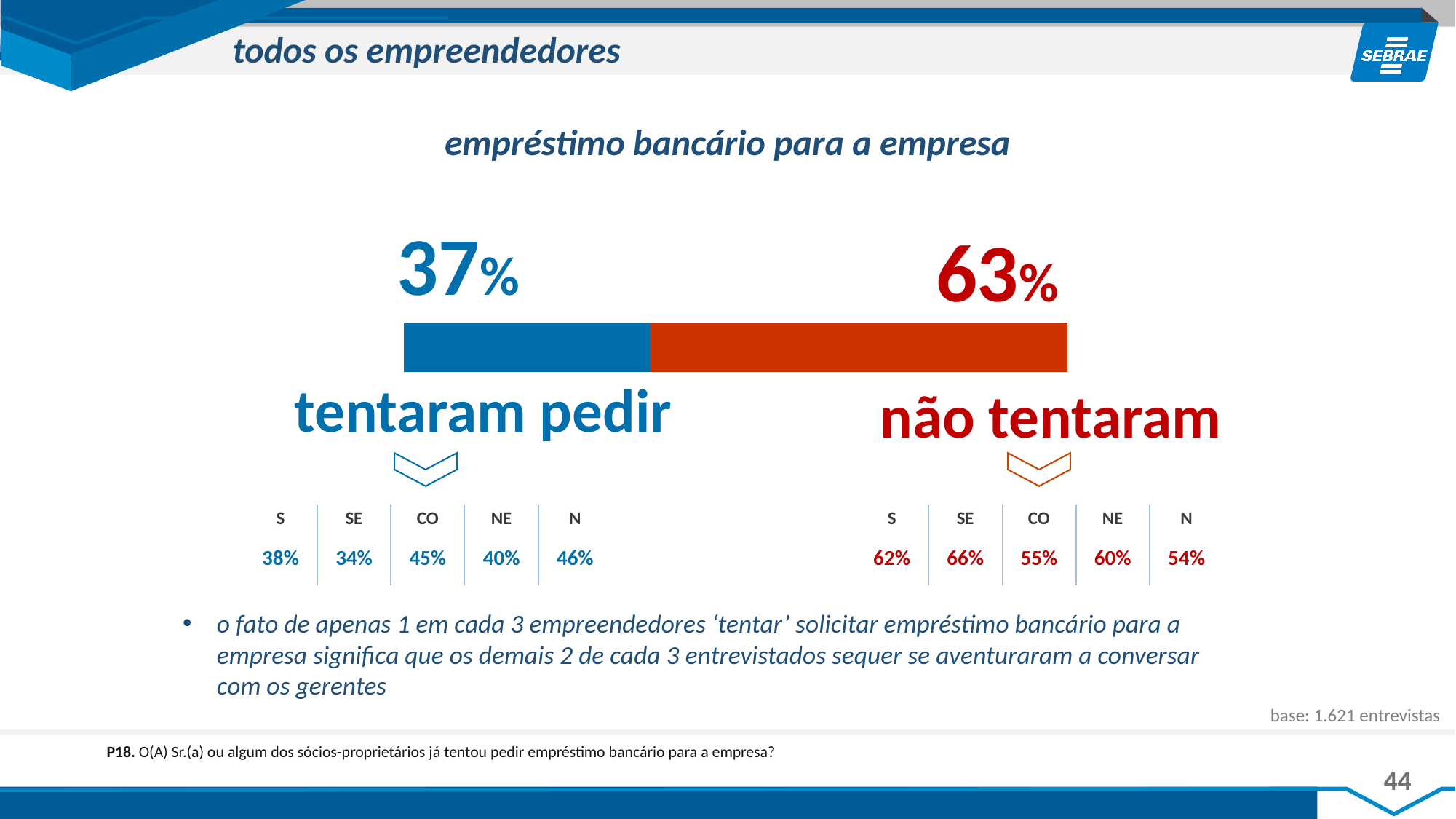
What is the difference in percentage points between "não tentaram" and "tentaram pedir"? 26 What colour is the "não tentaram" segment of the bar? Red What is the total of the two segments of the stacked bar? 100% How many segments does the bar have? 2 What percentage of entrepreneurs in the CO region did not try to ask for a bank loan? 55% What kind of chart is shown on the slide? Stacked horizontal bar chart What percentage of entrepreneurs did not try to ask for a bank loan ("não tentaram")? 63% Among the regions listed under "tentaram pedir", which region has the highest percentage? N (46%) Which segment of the bar is larger, "tentaram pedir" or "não tentaram"? não tentaram What is the title of the chart? empréstimo bancário para a empresa Among the regions listed under "tentaram pedir", which region has the lowest percentage? SE (34%) What percentage of entrepreneurs tried to ask for a bank loan for the company ("tentaram pedir")? 37%